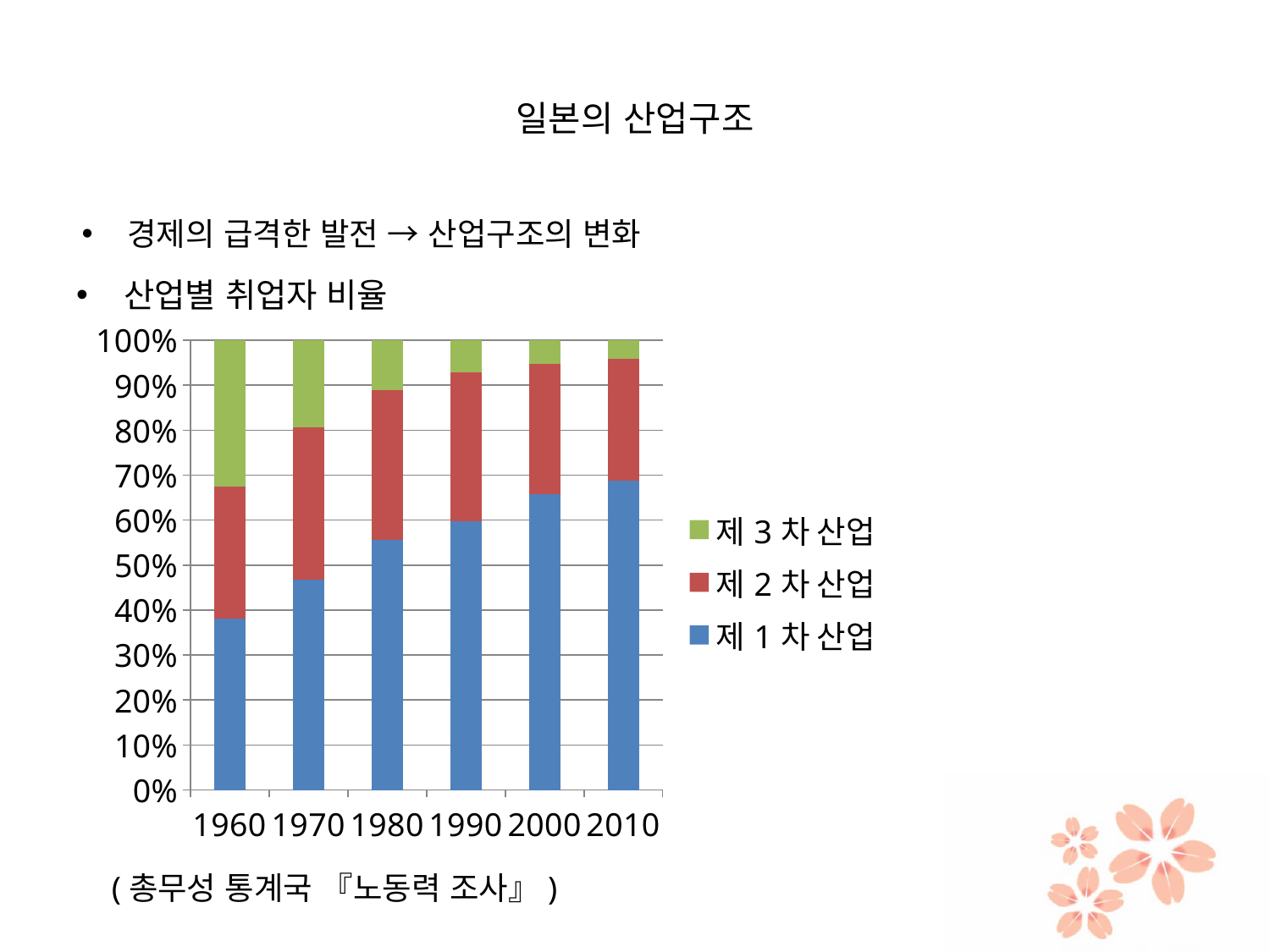
Is the value for 제 1 차 산업 in 2010 greater or less than 60%? greater In which year is the share of 제 1 차 산업 the smallest? 1960 How many series does the chart legend list? 3 Does the share of 제 1 차 산업 rise or fall from 1960 to 2010? rise How many years are shown on the x axis of the chart? 6 Which series is shown in blue in the chart? 제 1 차 산업 Is the value for 제 1 차 산업 in 1960 greater or less than 40%? less Which year has the larger share of 제 3 차 산업, 1960 or 2010? 1960 Which series is shown in green in the chart? 제 3 차 산업 Is the value for 제 1 차 산업 in 1980 greater or less than 50%? greater What kind of chart is shown on the slide? stacked bar chart In which year is the share of 제 3 차 산업 the largest? 1960